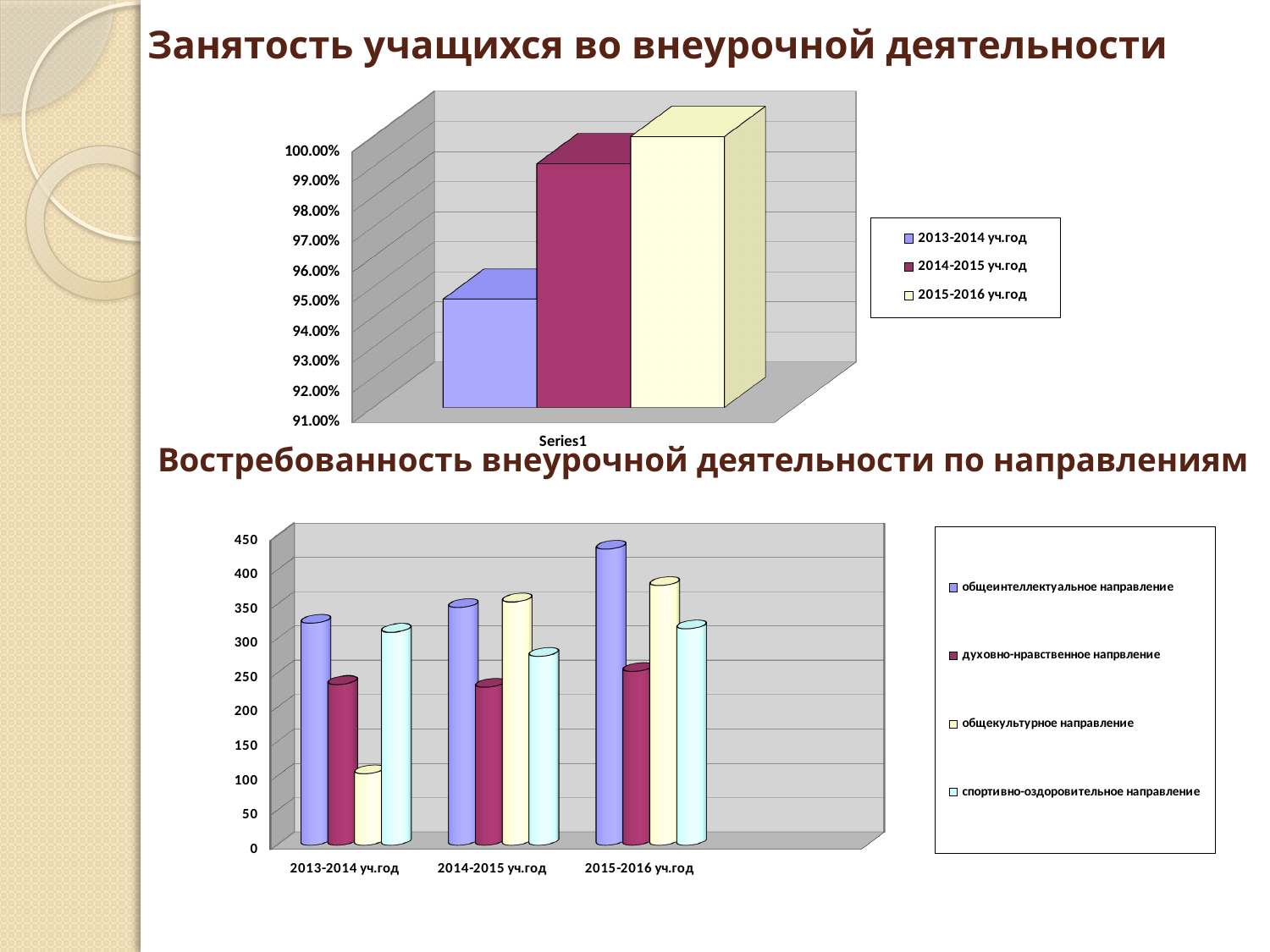
In the bottom chart "Востребованность внеурочной деятельности по направлениям", is the value for общекультурное направление in 2013-2014 уч.год greater or less than 150? less In the bottom chart "Востребованность внеурочной деятельности по направлениям", how many categories are shown on the x axis? 3 In the top chart "Занятость учащихся во внеурочной деятельности", which series has the lowest value? 2013-2014 уч.год In the bottom chart "Востребованность внеурочной деятельности по направлениям", which direction has the lowest value in 2013-2014 уч.год? общекультурное направление In the top chart "Занятость учащихся во внеурочной деятельности", is the value for 2013-2014 уч.год greater or less than 97.00%? less In the top chart "Занятость учащихся во внеурочной деятельности", which series has the highest value? 2015-2016 уч.год In the top chart "Занятость учащихся во внеурочной деятельности", how many series does the legend list? 3 In the bottom chart "Востребованность внеурочной деятельности по направлениям", how many series does the legend list? 4 In the bottom chart "Востребованность внеурочной деятельности по направлениям", does the value for общеинтеллектуальное направление rise or fall from 2013-2014 уч.год to 2015-2016 уч.год? rise In the bottom chart "Востребованность внеурочной деятельности по направлениям", which direction has the highest value in 2015-2016 уч.год? общеинтеллектуальное направление In the top chart "Занятость учащихся во внеурочной деятельности", is the value for 2014-2015 уч.год greater or less than 98.00%? greater What kind of chart is the top chart titled "Занятость учащихся во внеурочной деятельности"? bar chart